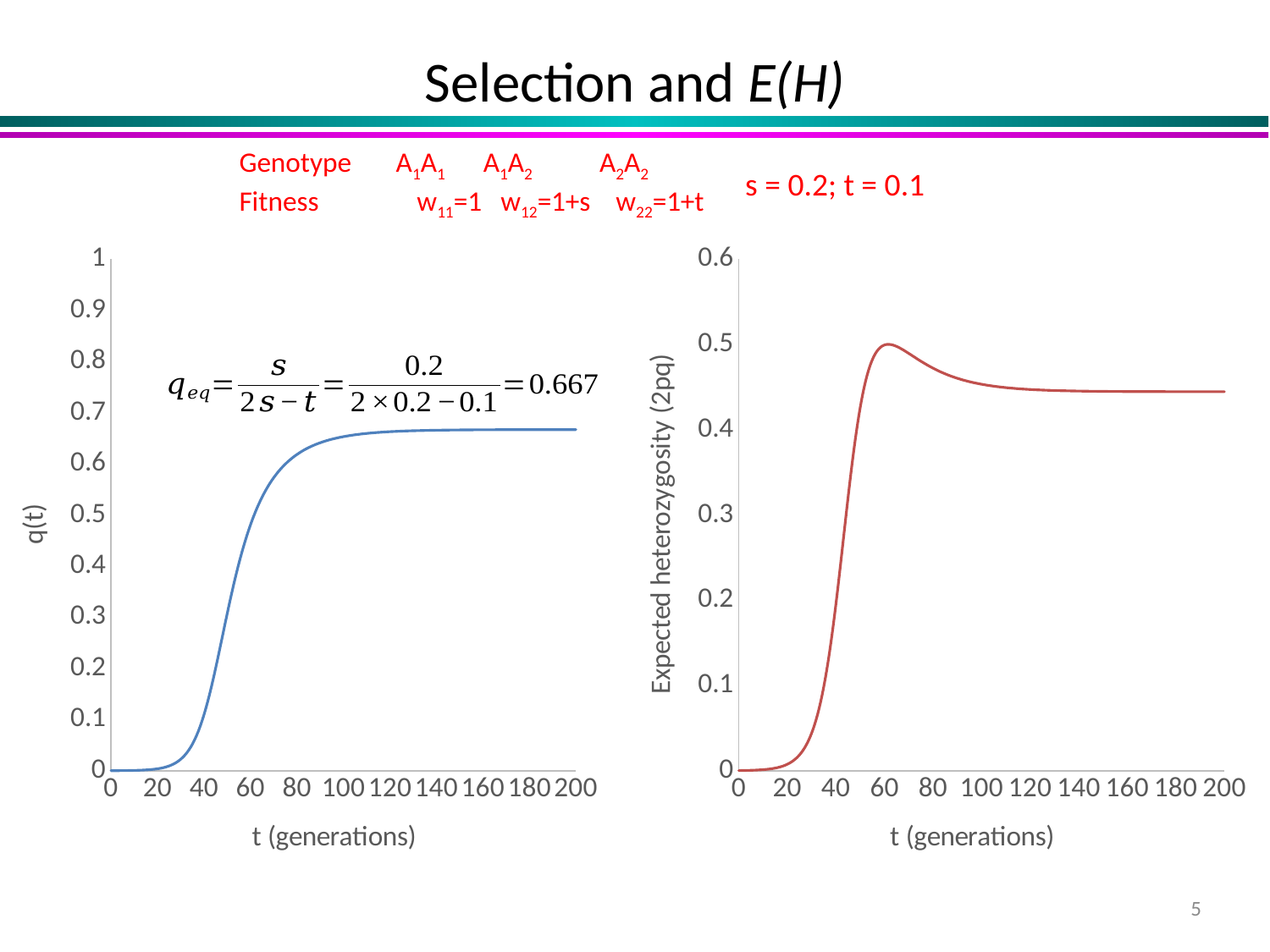
What kind of chart is the left chart with y-axis q(t)? line chart On the left chart, what is the label of the y-axis? q(t) On the right chart, is the expected heterozygosity at t = 20 generations greater or less than 0.1? less On the right chart, is the expected heterozygosity at t = 60 generations greater or less than 0.4? greater On the left chart, is the value of q(t) at t = 40 generations greater or less than 0.2? less How many charts are shown on the slide? 2 On the right chart, what is the label of the y-axis? Expected heterozygosity (2pq) On the right chart, does the expected heterozygosity rise or fall as t increases from 60 to 120 generations? fall What kind of chart is the right chart with y-axis Expected heterozygosity (2pq)? line chart On the left chart, does q(t) rise or fall as t increases from 0 to 100 generations? rise